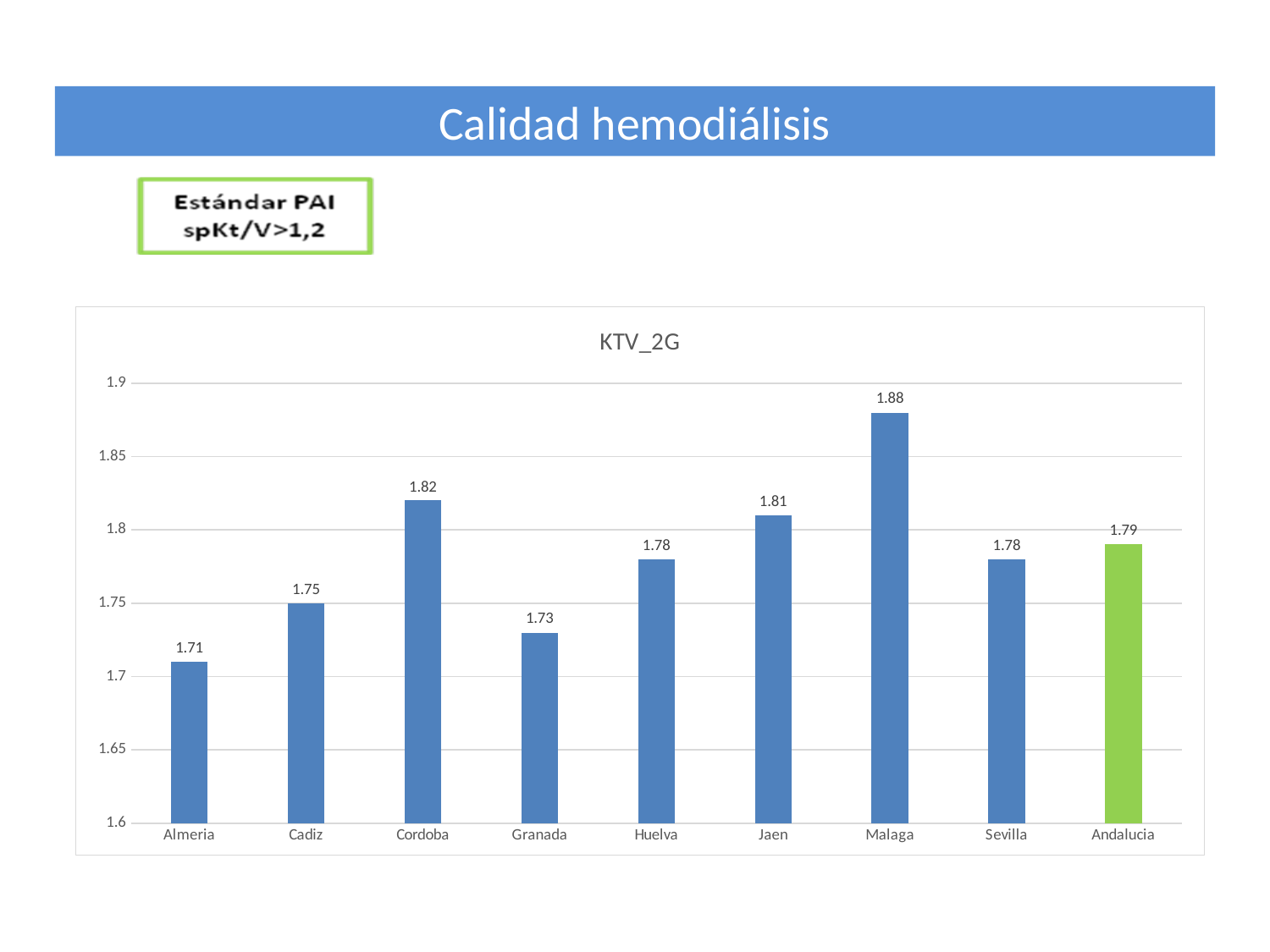
What is the KTV_2G value for Andalucia? 1.79 What is the KTV_2G value for Granada? 1.73 Which category has the highest KTV_2G value? Malaga How many categories are shown on the x axis of the chart? 9 Is the value for Cadiz greater or less than 1.8? less What is the title of the chart? KTV_2G What is the difference between the KTV_2G values for Malaga and Almeria? 0.17 What is the KTV_2G value for Malaga? 1.88 Which has a higher KTV_2G value, Cordoba or Jaen? Cordoba Which category's bar is coloured green instead of blue? Andalucia What kind of chart is shown on the slide? bar chart Which category has the lowest KTV_2G value? Almeria